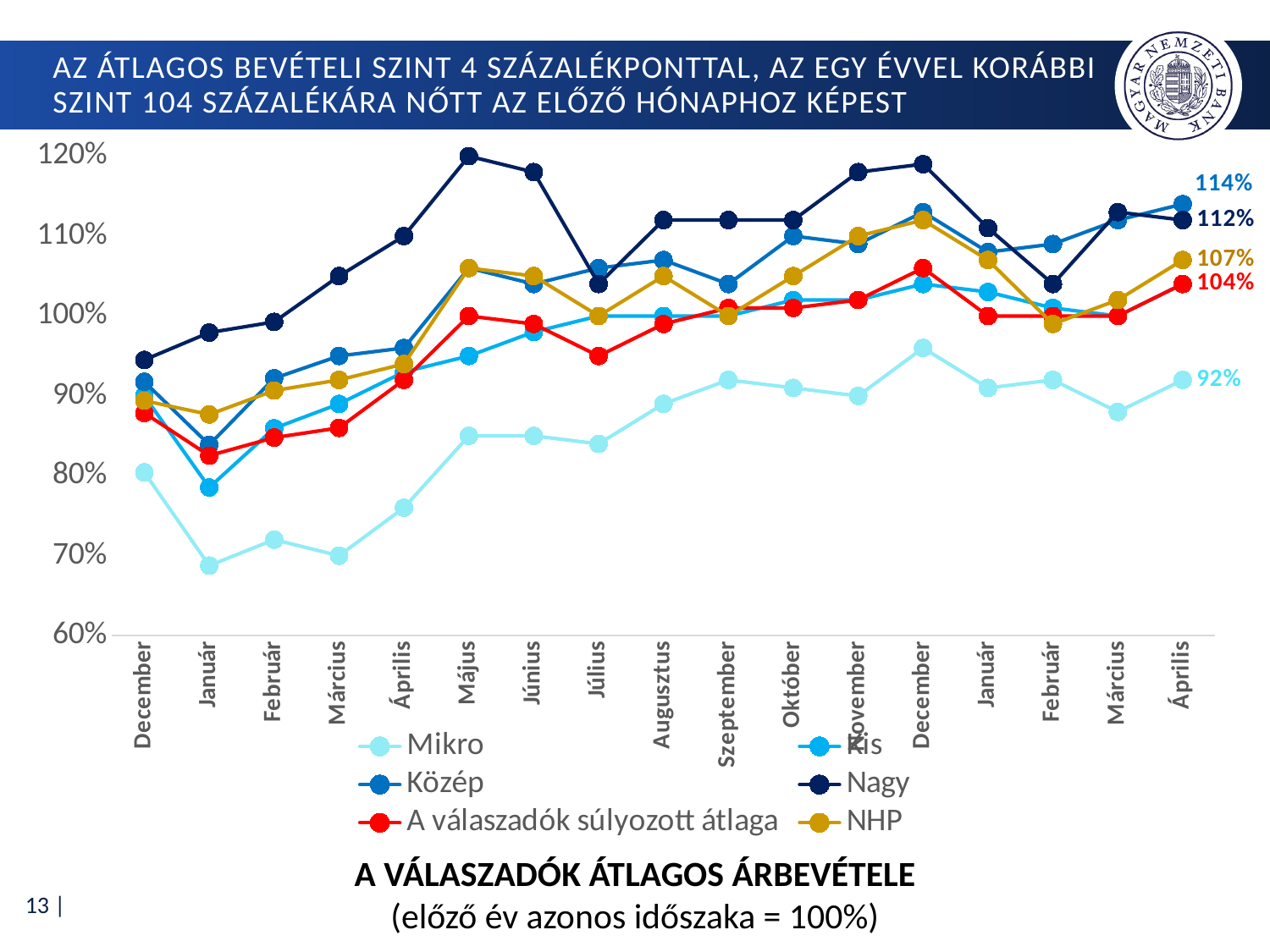
How many months are shown along the x axis? 17 What is the value of the Nagy series at the final Április point? 112% How many series does the legend list? 6 What is the value of the Mikro series at the final Április point? 92% What is the difference in percentage points between the Közép and Mikro values at the final Április point? 22 percentage points Which series has the highest value at the final Április point? Közép What is the value of the NHP series at the final Április point? 107% Is the value of the Mikro series in the first Január greater or less than 70%? less What kind of chart is shown on the slide? line chart Which series has the lowest value at the final Április point? Mikro What is the value of the Közép series at the final Április point? 114% Which series is highest in Május? Nagy